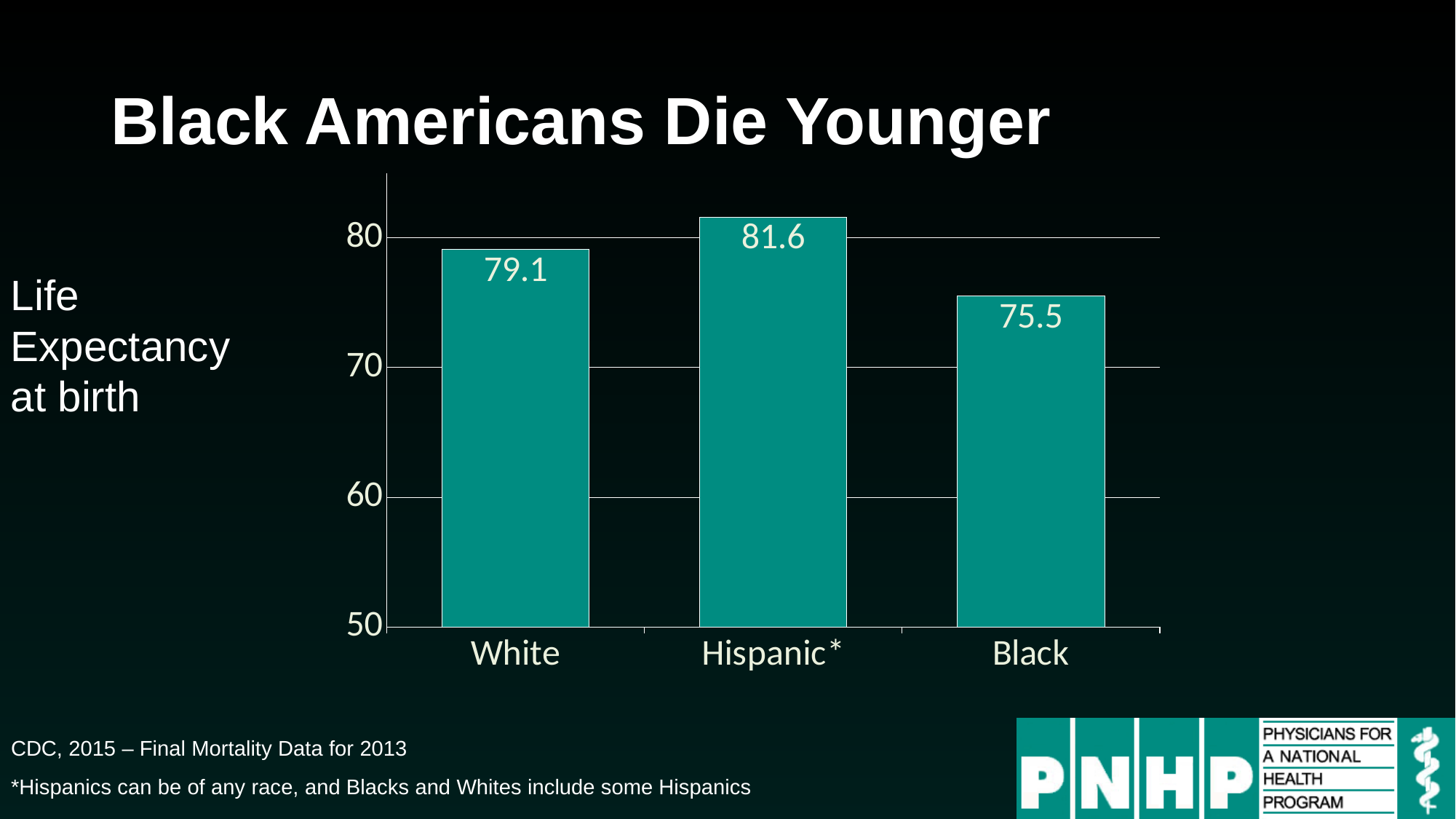
What is the life expectancy at birth for White Americans? 79.1 What is the life expectancy at birth for Black Americans? 75.5 Which group has the lowest life expectancy at birth? Black Is the life expectancy for Black Americans greater or less than 80? less What is the difference in life expectancy between Hispanic and Black Americans? 6.1 What is the title of the slide? Black Americans Die Younger Which group has the highest life expectancy at birth? Hispanic What is the life expectancy at birth for Hispanic Americans? 81.6 What kind of chart is shown on the slide? bar chart What is the difference in life expectancy between White and Black Americans? 3.6 Which is larger, the life expectancy for White or for Hispanic Americans? Hispanic How many groups are shown in the chart? 3